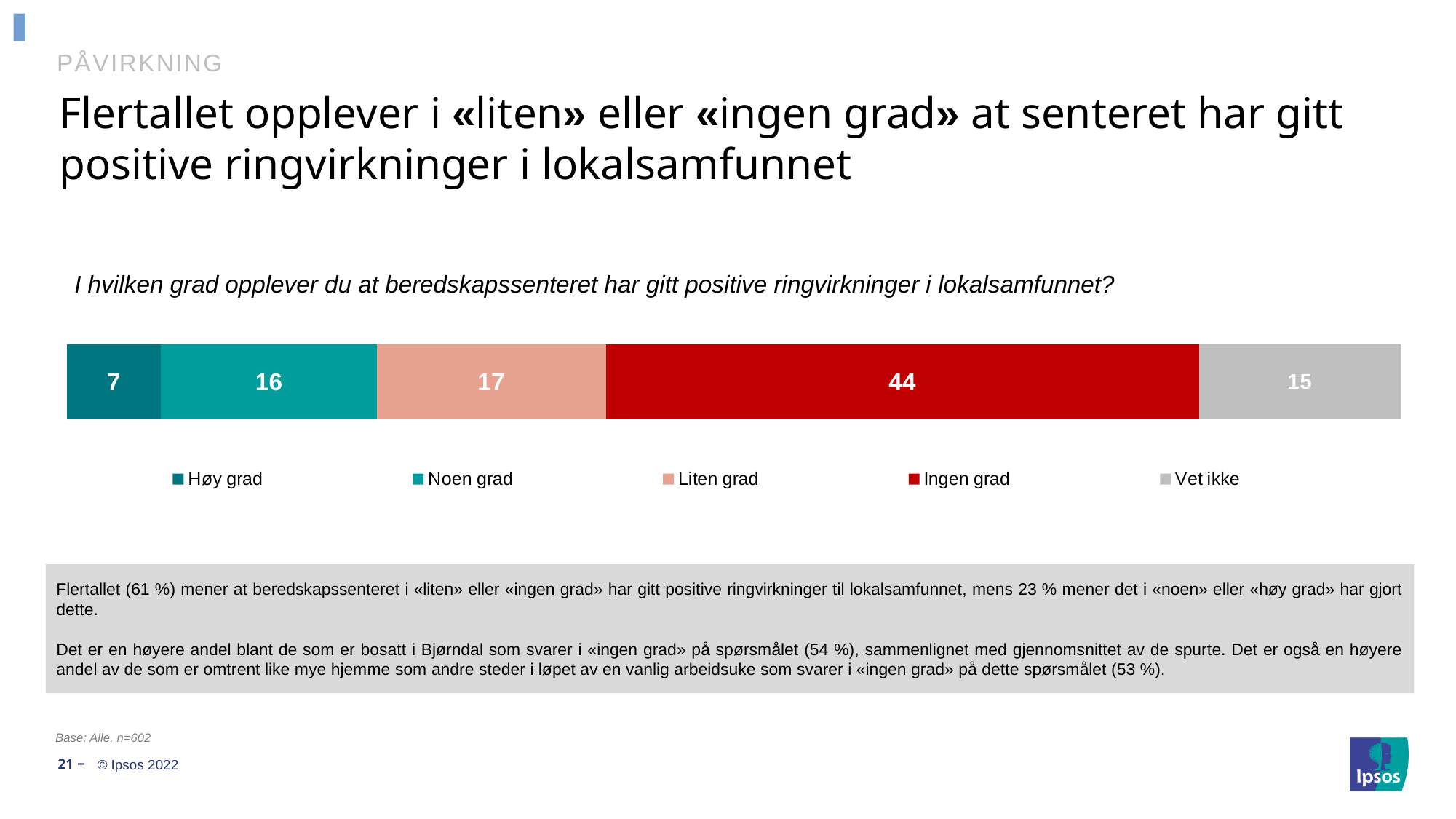
What value is shown for "Liten grad" in the stacked bar? 17 Which response category has the smallest segment in the bar? Høy grad What kind of chart is shown on the slide? Stacked bar chart What is the total of all segments in the stacked bar? 99 Which response category has the largest segment in the bar? Ingen grad What value is shown for "Ingen grad" in the stacked bar? 44 What is the difference between the values for "Ingen grad" and "Liten grad"? 27 Which is larger, the value for "Noen grad" or the value for "Vet ikke"? Noen grad What colour is the "Ingen grad" segment in the bar? Red What value is shown for "Høy grad" in the stacked bar? 7 What value is shown for "Vet ikke" in the stacked bar? 15 How many series does the legend list? 5